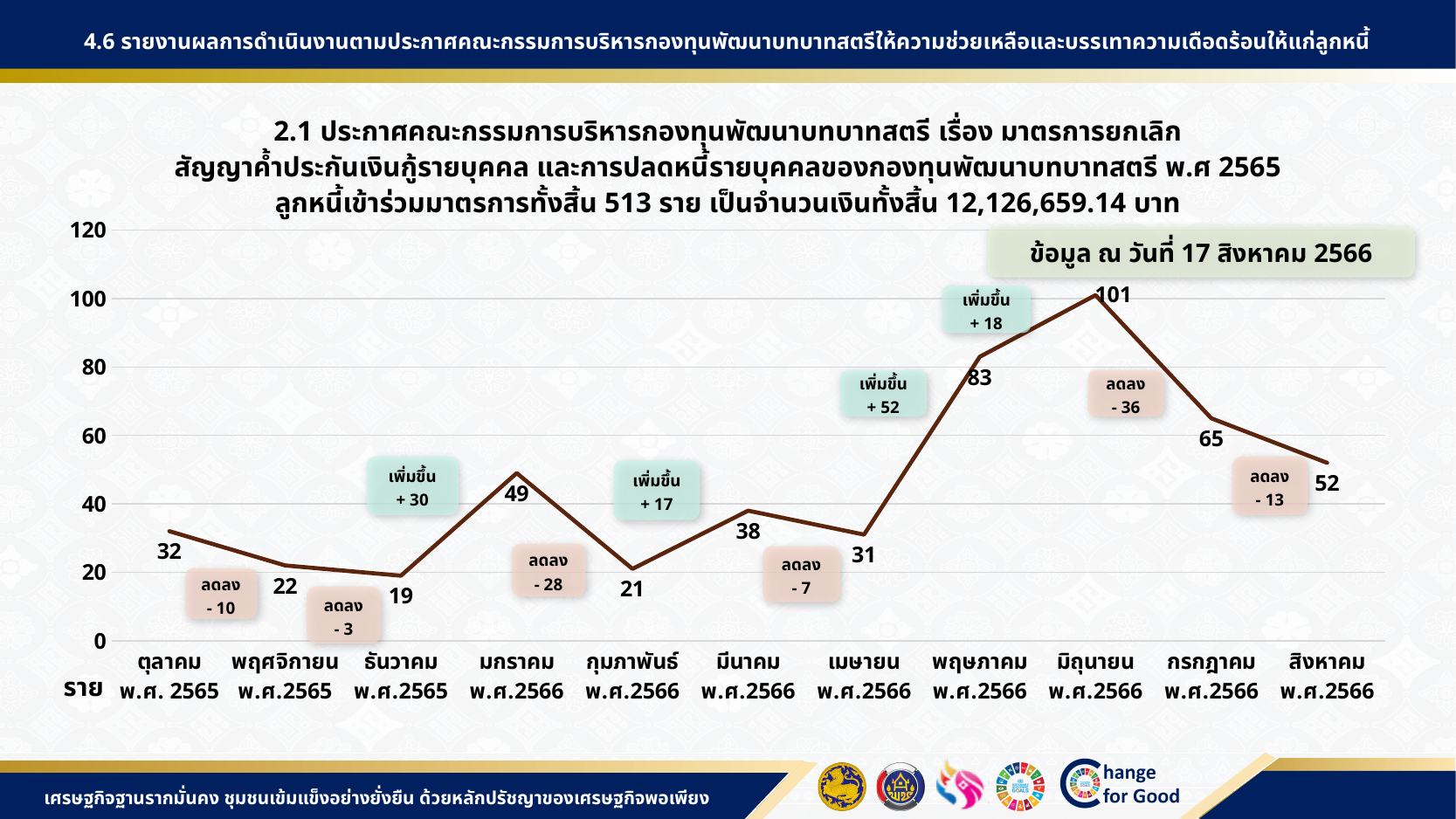
What is the difference between the values for พฤษภาคม พ.ศ.2566 (83) and เมษายน พ.ศ.2566 (31)? 52 How many months (data points) are plotted on the chart? 11 Does the value rise or fall from มิถุนายน พ.ศ.2566 to สิงหาคม พ.ศ.2566? fall What is the value for สิงหาคม พ.ศ.2566 (August 2566)? 52 What is the value for มิถุนายน พ.ศ.2566 (June 2566)? 101 Which month has the highest value on the chart? มิถุนายน พ.ศ.2566 Which month has the lowest value on the chart? ธันวาคม พ.ศ.2565 Is the value for กรกฎาคม พ.ศ.2566 greater or less than 60? greater What is the value for ตุลาคม พ.ศ. 2565 (October 2565)? 32 What date is the data on the chart reported as of, according to the label in the top right? 17 สิงหาคม 2566 Which is larger, the value for มกราคม พ.ศ.2566 or the value for มีนาคม พ.ศ.2566? มกราคม พ.ศ.2566 What type of chart is shown on the slide? line chart